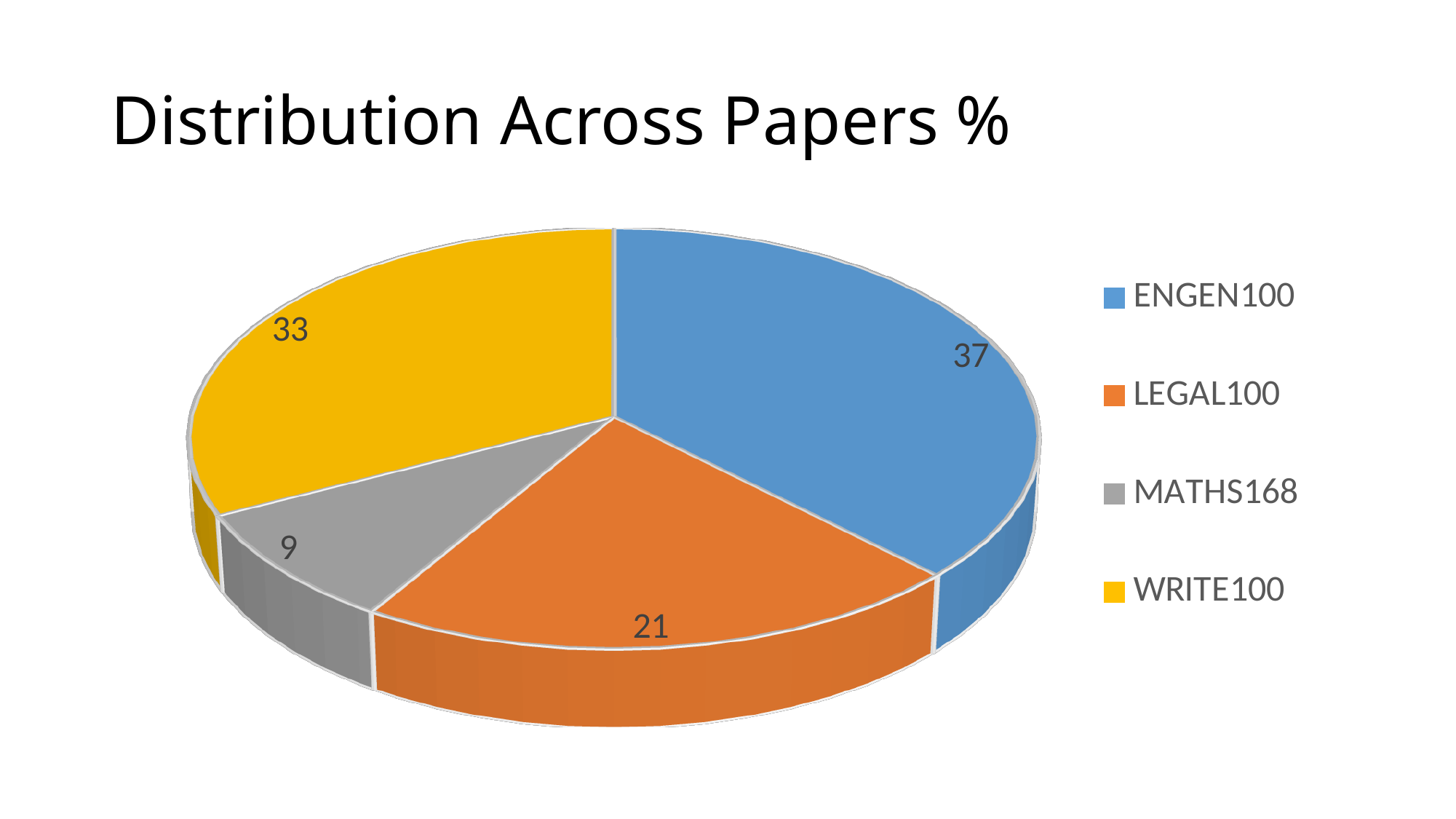
How many papers are shown in the pie chart? 4 What is the value for WRITE100? 33 What is the title of the chart? Distribution Across Papers % Which paper has the smallest slice? MATHS168 Which paper has the largest slice? ENGEN100 What is the value for MATHS168? 9 What is the difference between the values for LEGAL100 and MATHS168? 12 What is the value for LEGAL100? 21 What kind of chart is shown on the slide? Pie chart What is the difference between the values for ENGEN100 and WRITE100? 4 Which is larger, the value for WRITE100 or the value for LEGAL100? WRITE100 What is the value for ENGEN100? 37